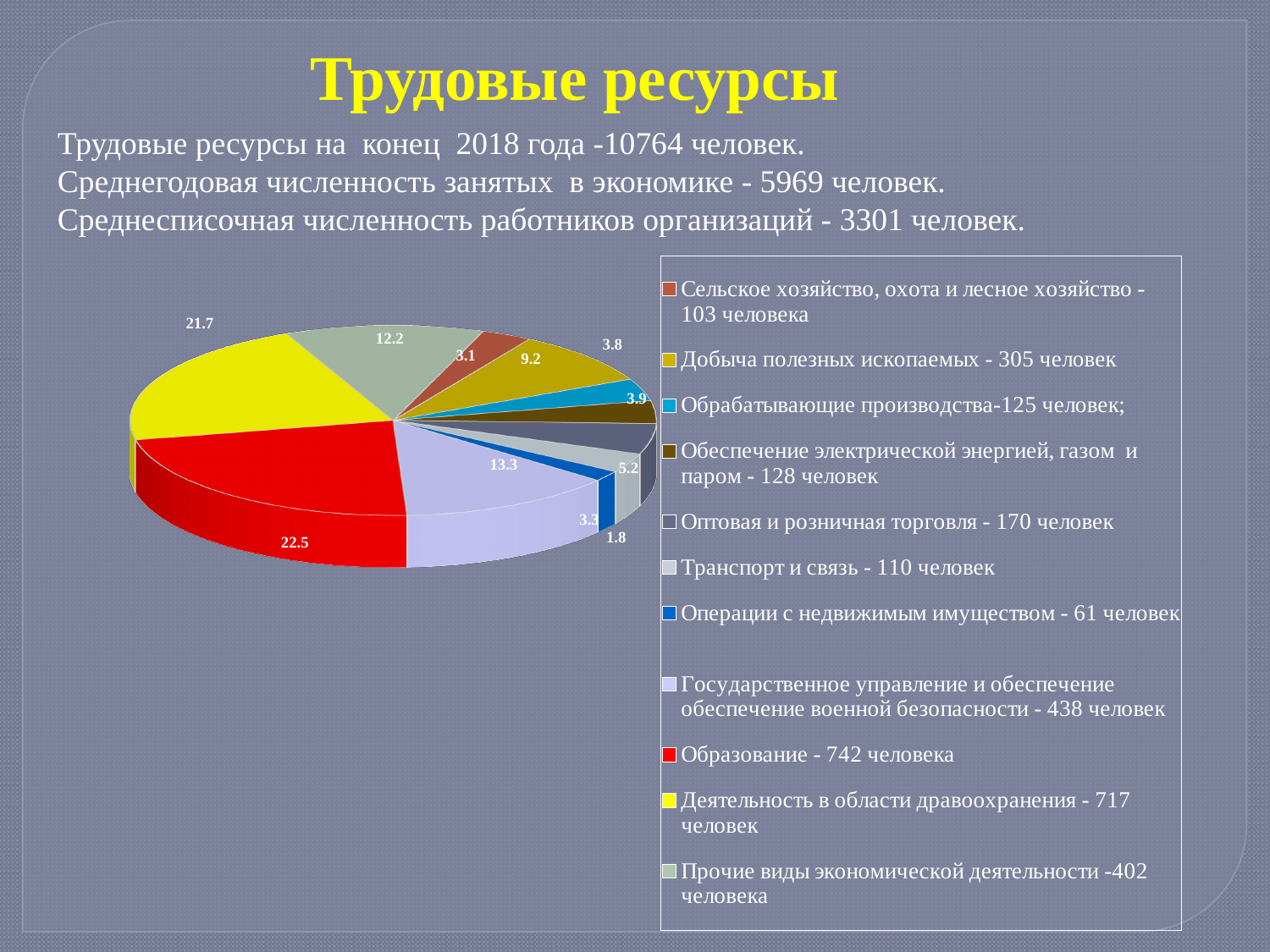
How many categories (slices) does the pie chart have? 11 According to the legend, how many people are in Образование? 742 человека Which category has the largest slice in the pie chart? Образование What is the difference between the labelled values for Образование and Деятельность в области здравоохранения? 0.8 What value is labelled on the slice for Государственное управление и обеспечение военной безопасности? 13.3 According to the legend, how many people are in Добыча полезных ископаемых? 305 человек Which category has the smallest slice in the pie chart? Операции с недвижимым имуществом What kind of chart is shown on the slide? Pie chart What value is labelled on the slice for Деятельность в области здравоохранения? 21.7 Which slice is larger: Государственное управление и обеспечение военной безопасности or Прочие виды экономической деятельности? Государственное управление и обеспечение военной безопасности What value is labelled on the slice for Прочие виды экономической деятельности? 12.2 What value is labelled on the slice for Образование? 22.5